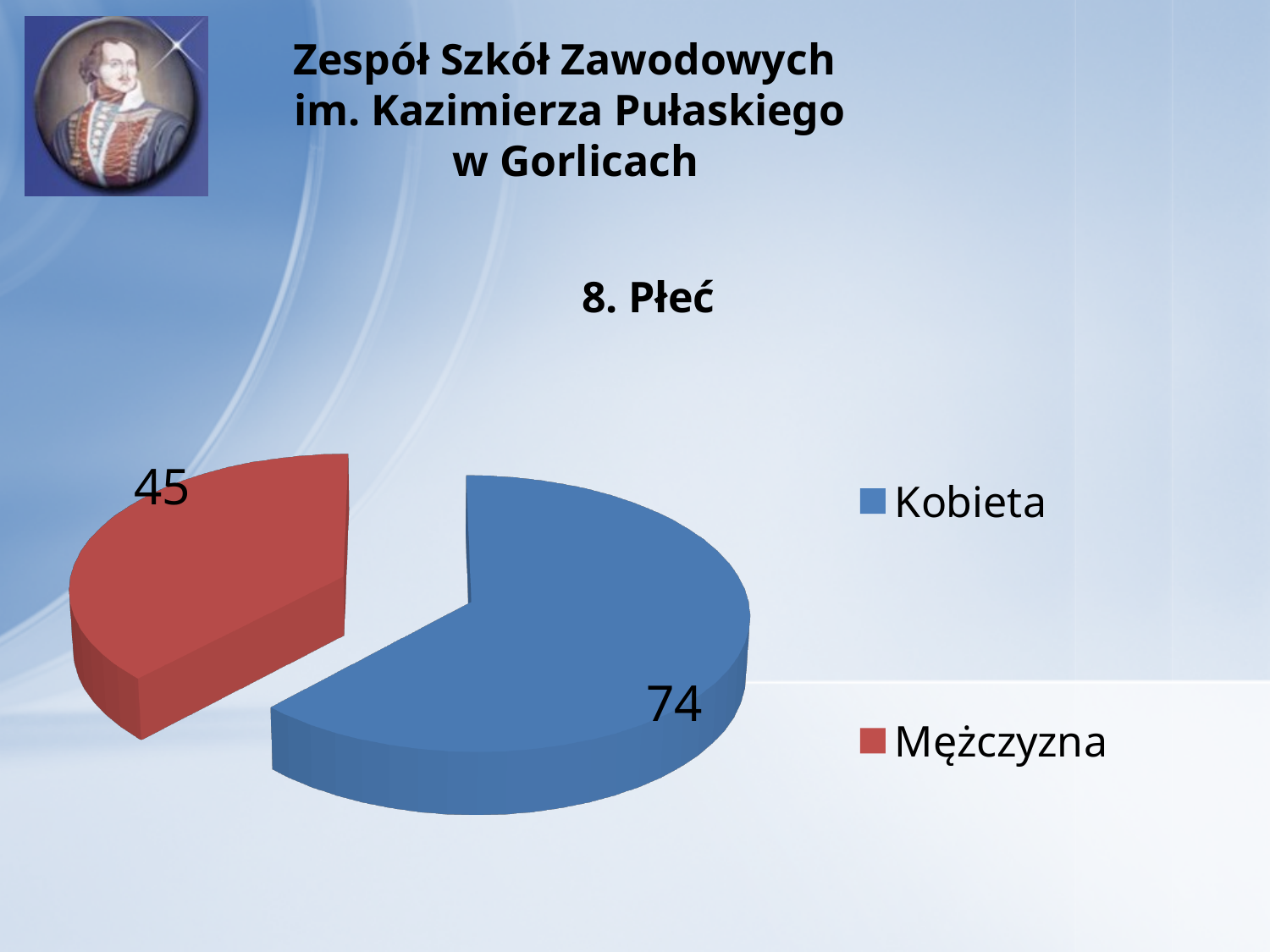
What colour is the Mężczyzna slice in the pie chart? red Which category has the smallest slice in the pie chart? Mężczyzna What is the total of the two values shown in the pie chart? 119 What is the value for Kobieta in the pie chart? 74 What is the value for Mężczyzna in the pie chart? 45 What kind of chart is shown on the slide? pie chart What is the title of the chart? 8. Płeć What is the difference between the values for Kobieta and Mężczyzna? 29 How many entries does the legend list? 2 How many categories are shown in the pie chart? 2 Which is larger, the value for Kobieta or the value for Mężczyzna? Kobieta Which category has the largest slice in the pie chart? Kobieta